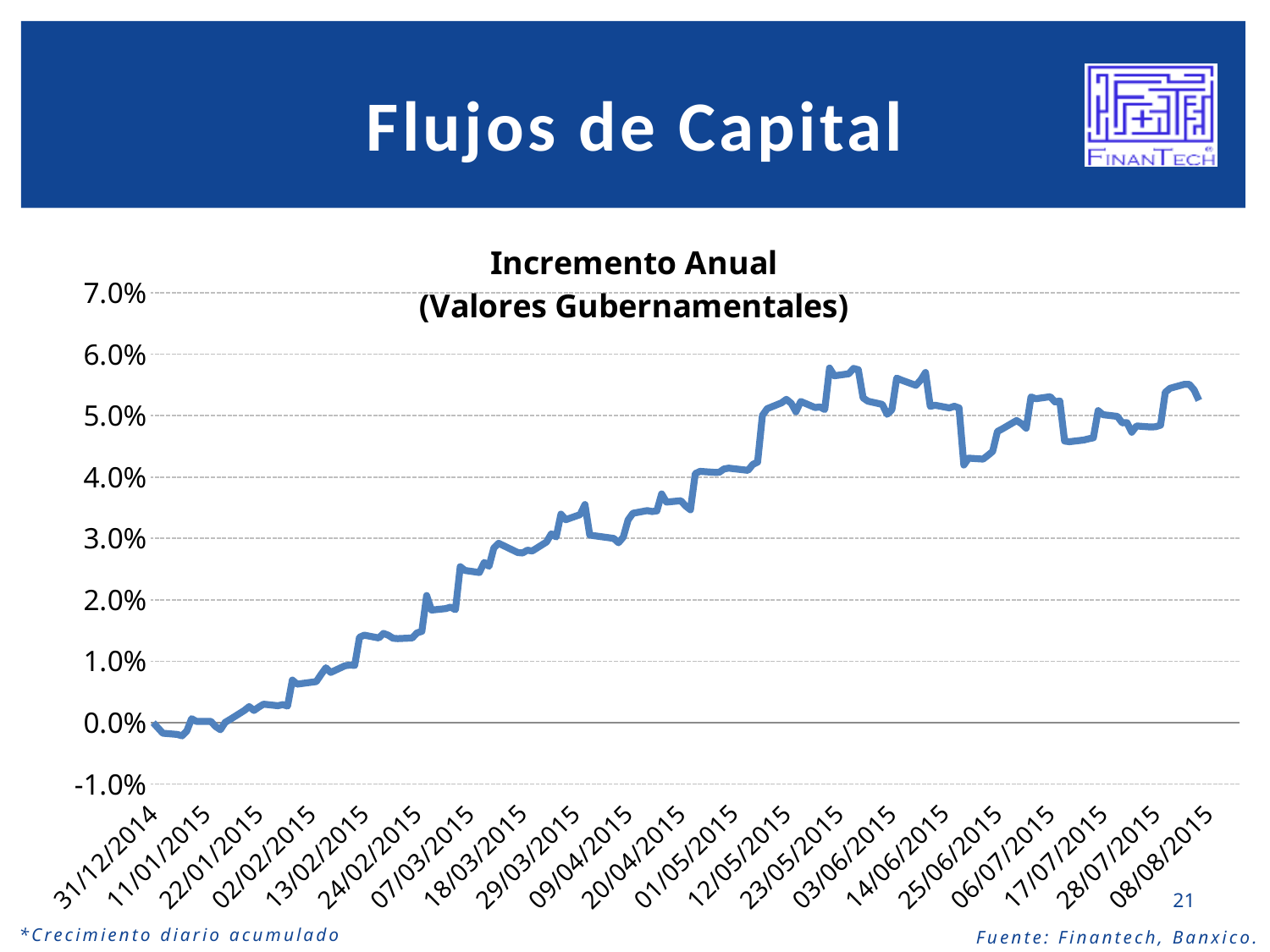
How many date labels are shown on the x axis? 21 Is the value at 23/05/2015 greater or less than 5.0%? greater Which has the larger value, 23/05/2015 or 25/06/2015? 23/05/2015 Is the highest value on the line greater or less than 5.0%? greater Which has the larger value, 31/12/2014 or 08/08/2015? 08/08/2015 What is the title of the chart? Incremento Anual (Valores Gubernamentales) Is the value at 18/03/2015 greater or less than 2.0%? greater What kind of chart is shown on the slide? line chart Overall, do the values rise or fall from 31/12/2014 to 08/08/2015? rise